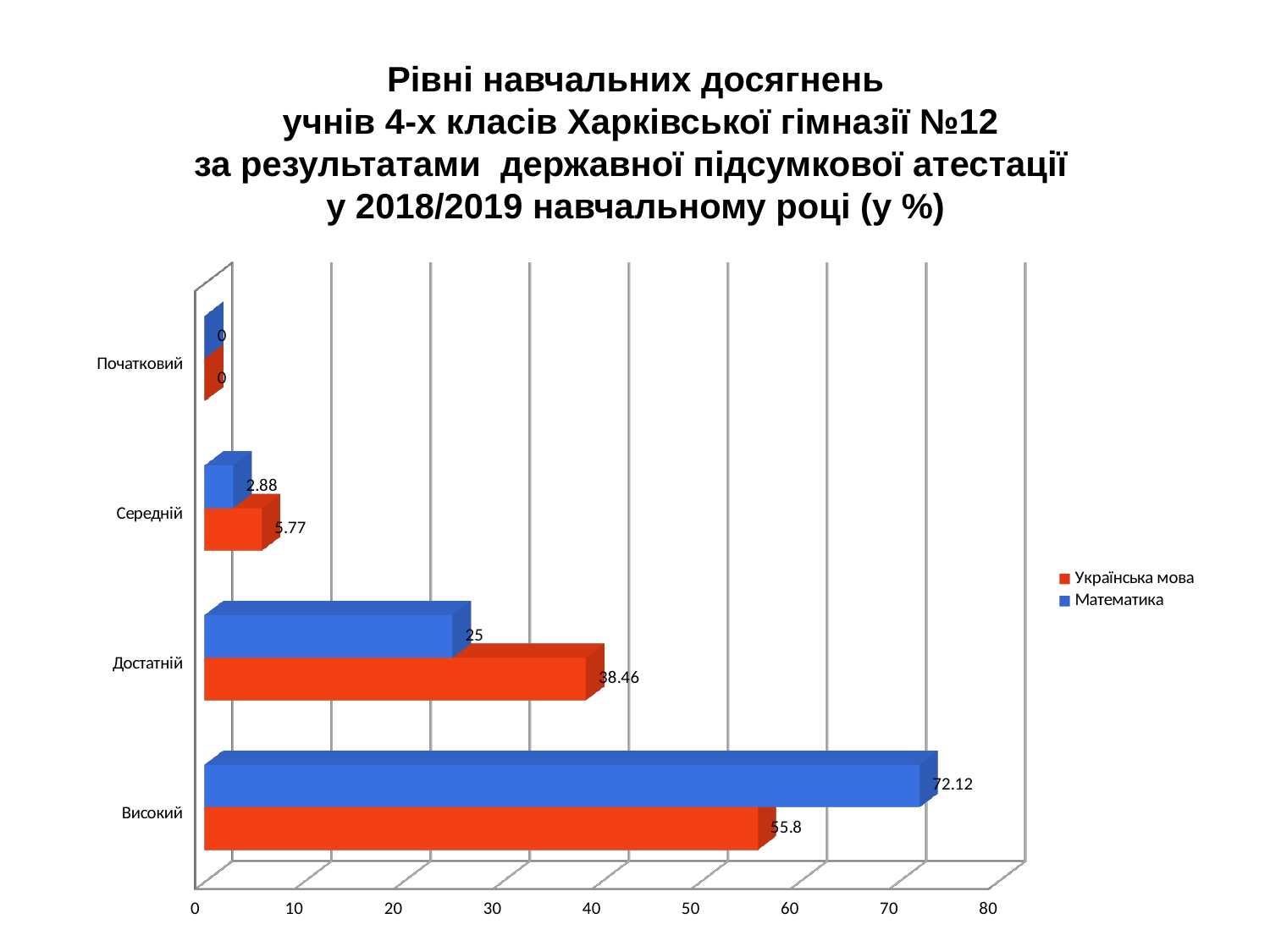
How many categories are shown on the chart? 4 What is the value for Математика in the Високий category? 72.12 Which category has the lowest value for Математика? Початковий What is the value for Математика in the Достатній category? 25 How many series does the legend list? 2 What is the value for Українська мова in the Достатній category? 38.46 Which category has the highest value for Українська мова? Високий What is the difference between the Математика and Українська мова values in the Високий category? 16.32 What is the value for Українська мова in the Середній category? 5.77 Which colour represents Математика in the chart? Blue In the Достатній category, which series has the larger value, Українська мова or Математика? Українська мова What kind of chart is shown on the slide? Bar chart